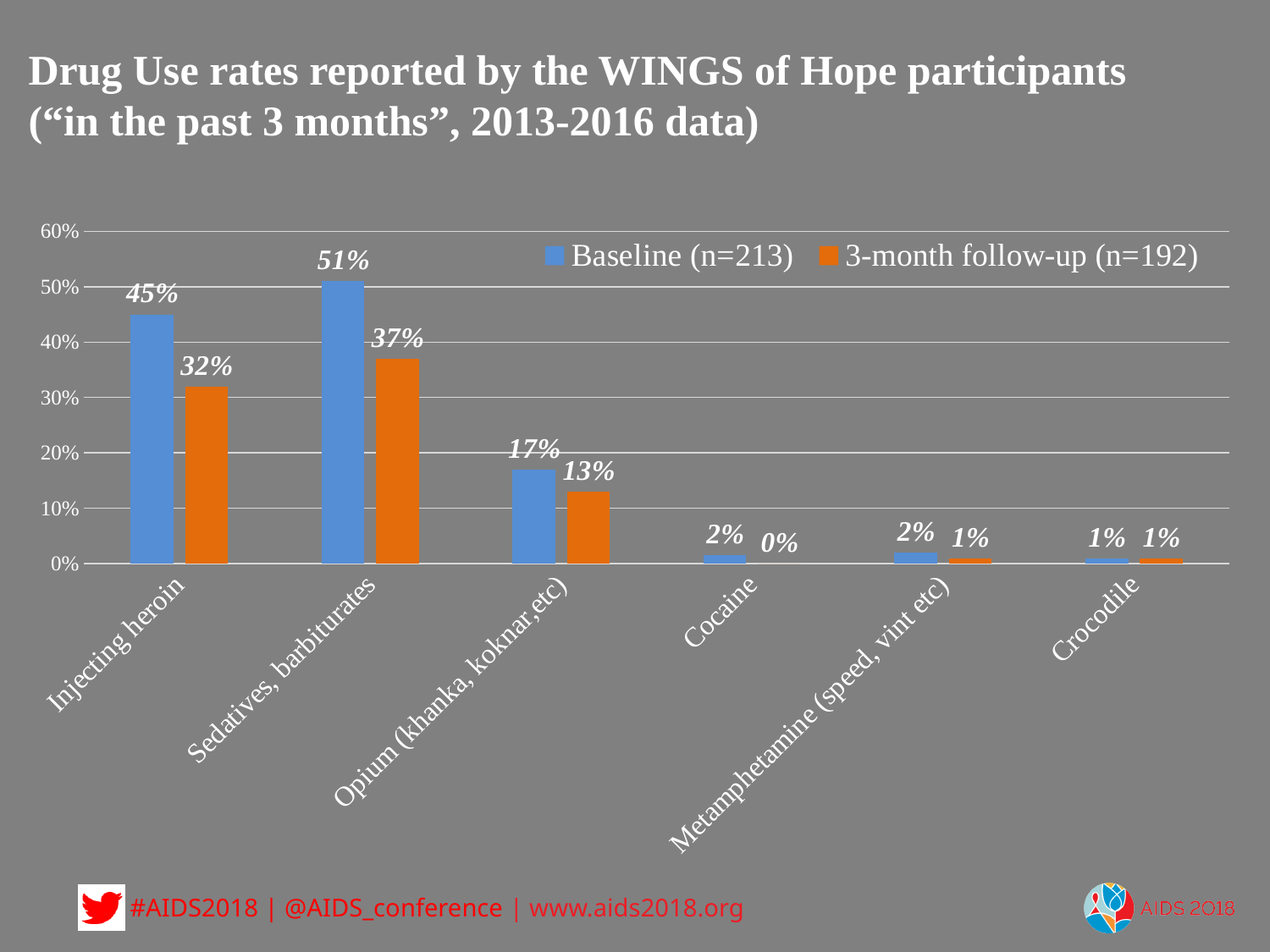
What is the difference between the Baseline and 3-month follow-up values for Injecting heroin? 13% What is the 3-month follow-up value for Sedatives, barbiturates? 37% How many series does the legend list? 2 What is the Baseline value for Injecting heroin? 45% Which drug category has the lowest 3-month follow-up value? Cocaine Which is larger: the Baseline value for Injecting heroin or the 3-month follow-up value for Sedatives, barbiturates? Baseline value for Injecting heroin What is the Baseline value for Opium (khanka, koknar, etc)? 17% Which drug category has the highest Baseline value? Sedatives, barbiturates What kind of chart is shown on the slide? Bar chart What is the difference between the Baseline values for Sedatives, barbiturates and Opium (khanka, koknar, etc)? 34% What is the 3-month follow-up value for Cocaine? 0% How many drug categories are shown on the x axis? 6